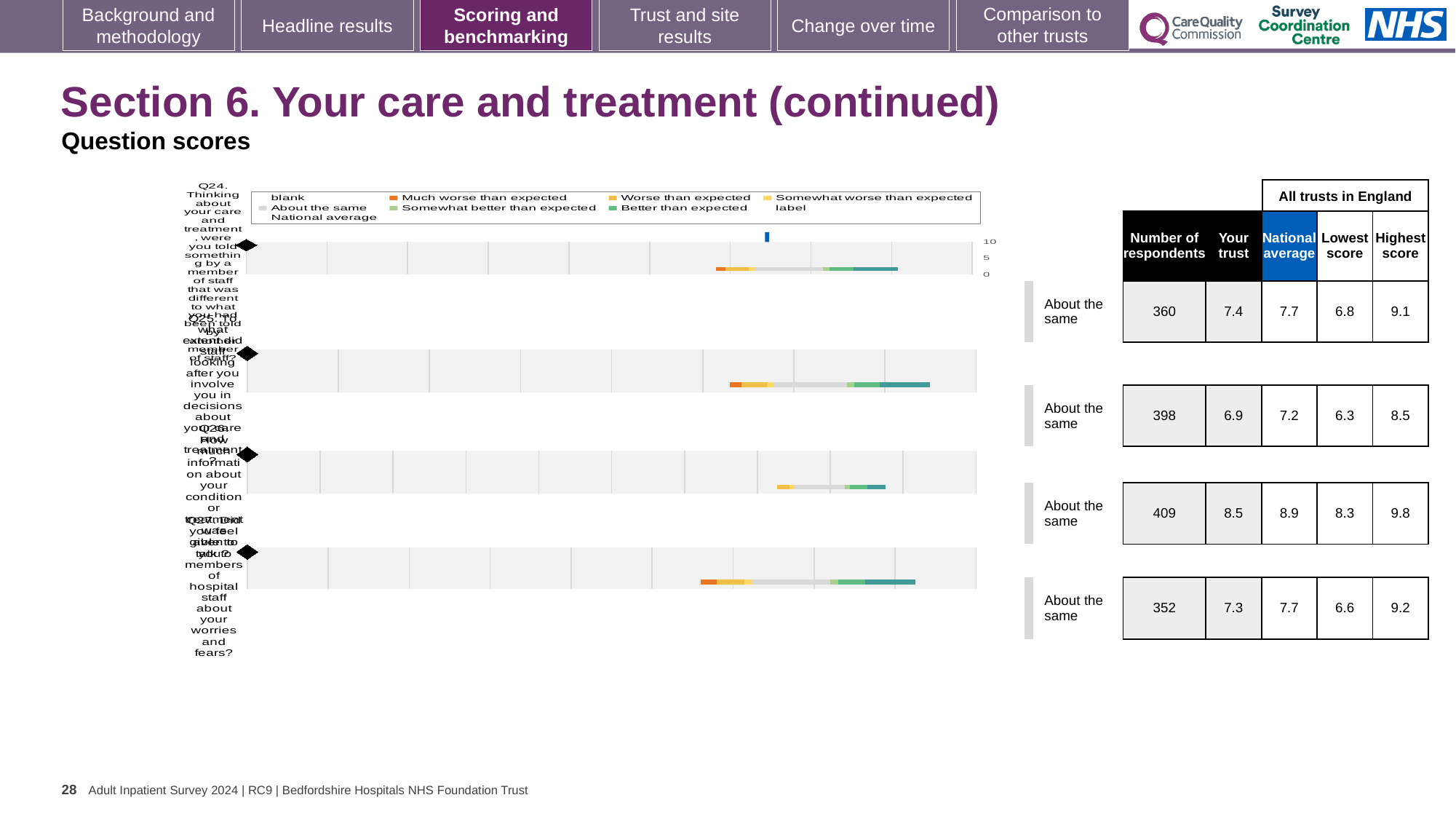
What kind of chart is used to show the question scores on this slide? bar chart What benchmark category is shown next to each of the four question charts? About the same In the Q24 chart, is the trust's score marker greater or less than 5 on the axis? greater For the Q27 chart, how many respondents are shown in the table beside it? 352 How many entries does the legend above the charts list? 9 For the Q25 chart, what is the national average score shown in the table beside it? 7.2 What is the difference between the national average and the 'Your trust' score for the Q27 chart? 0.4 How many question charts (Q24 to Q27) are shown on the slide? 4 For the Q26 chart, what is the highest score across all trusts in England shown in the table beside it? 9.8 What is the highest tick value shown on the axis of the Q24 chart? 10 For the Q24 chart, what is the 'Your trust' score shown in the table beside it? 7.4 Which of the four question charts has the highest 'Your trust' score in the table? Q26